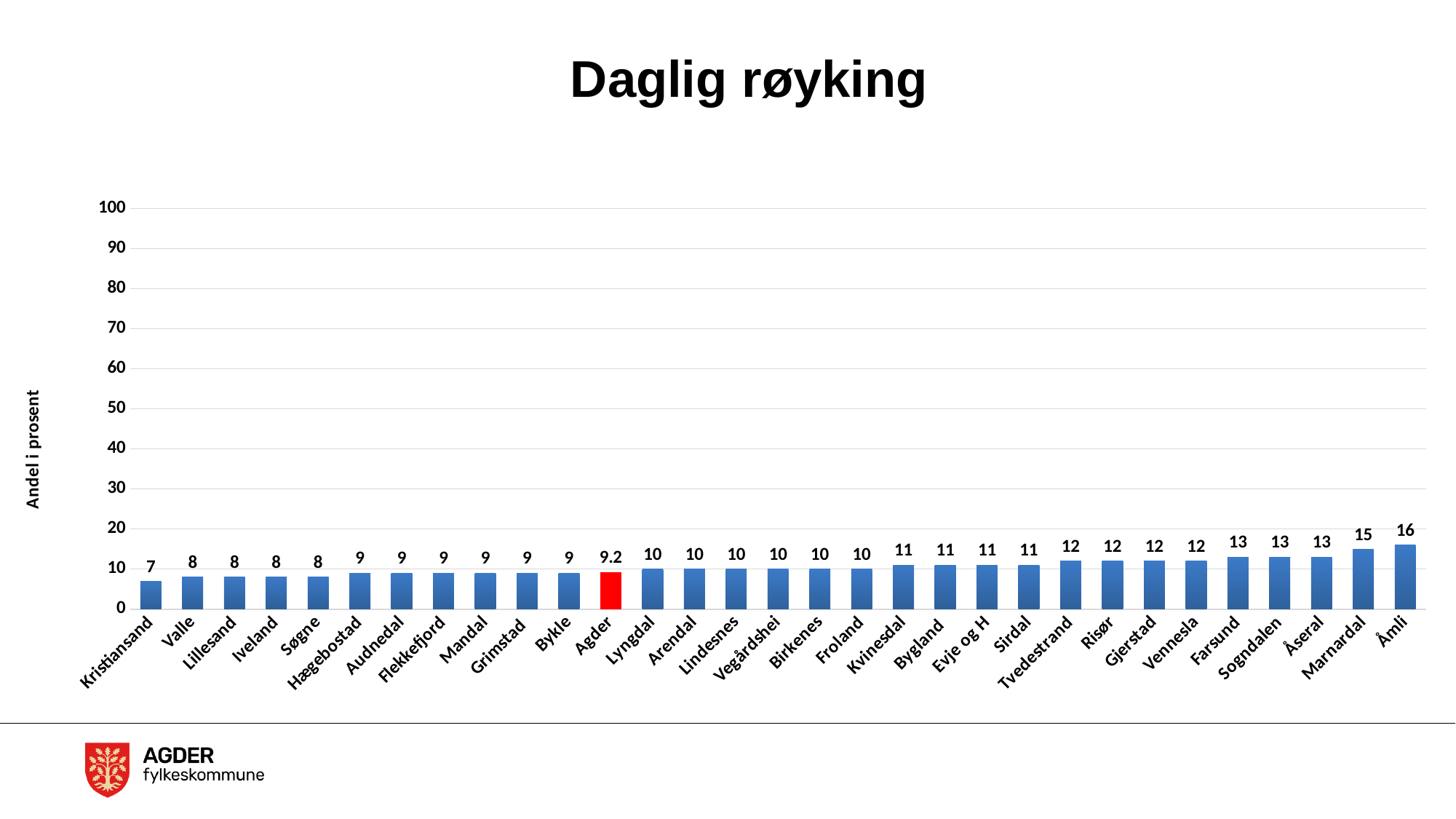
Which category has the lowest value? Kristiansand Which is larger, the value for Marnardal or the value for Farsund? Marnardal What is the value for Agder? 9.2 Is the value for Åmli greater or less than 20? less What kind of chart is this? bar chart What is the title of the chart? Daglig røyking Which category has the highest value? Åmli What is the difference between the values for Åmli and Kristiansand? 9 What is the value for Tvedestrand? 12 What is the value for Kristiansand? 7 How many categories are shown on the x axis? 31 What is the value for Åmli? 16